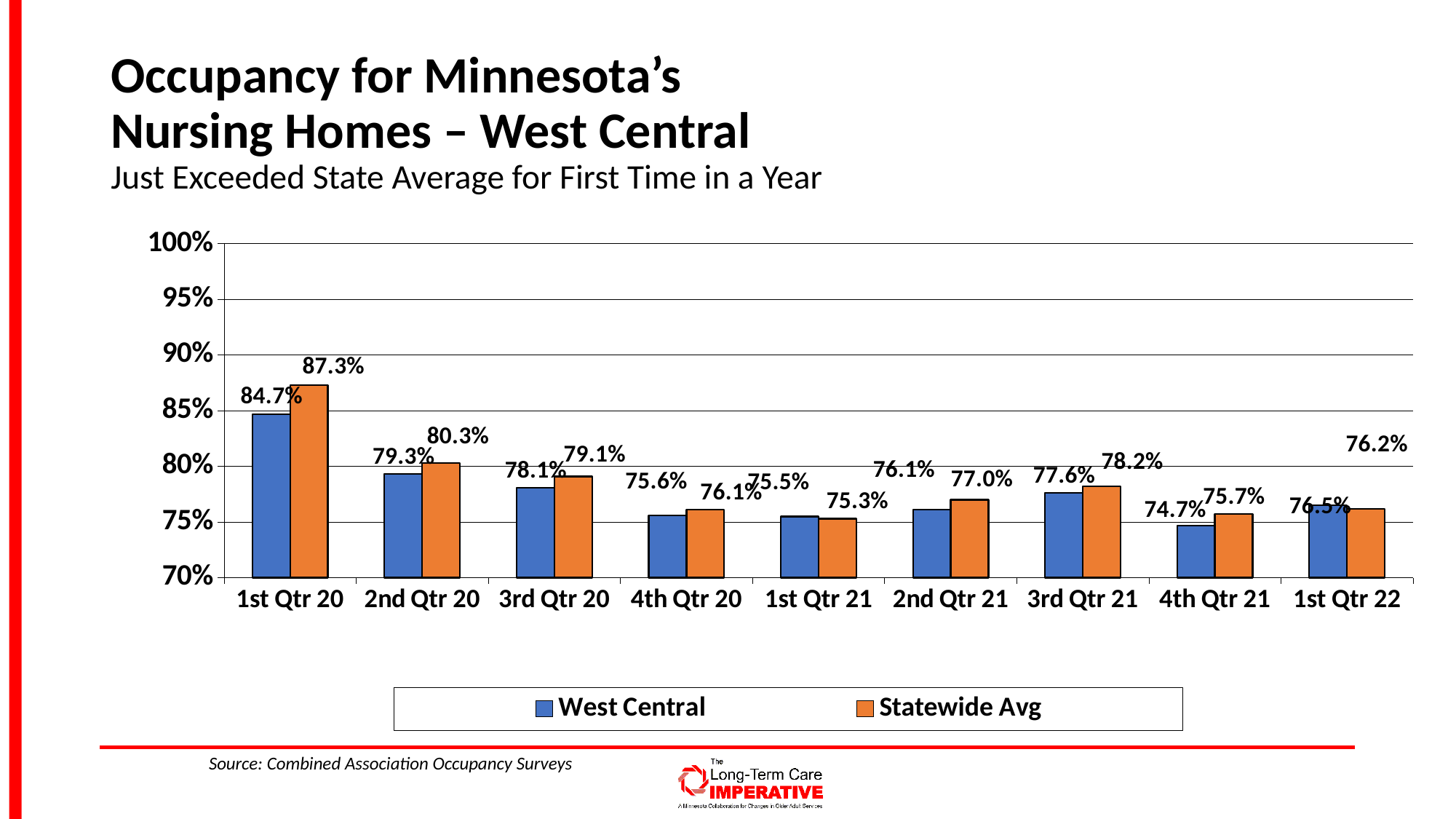
What is the difference between the Statewide Avg and West Central values in 1st Qtr 20? 2.6% What is the Statewide Avg value for 1st Qtr 22? 76.2% In which quarter is the West Central occupancy the lowest? 4th Qtr 21 In 2nd Qtr 21, which is larger: West Central or Statewide Avg? Statewide Avg What is the West Central occupancy value for 1st Qtr 20? 84.7% Which colour represents the Statewide Avg series? orange How many quarters are shown on the x axis? 9 How many series does the legend list? 2 Is the West Central value for 4th Qtr 21 greater or less than 75%? less What is the Statewide Avg value for 3rd Qtr 21? 78.2% In which quarter is the Statewide Avg the highest? 1st Qtr 20 What kind of chart is shown on the slide? bar chart